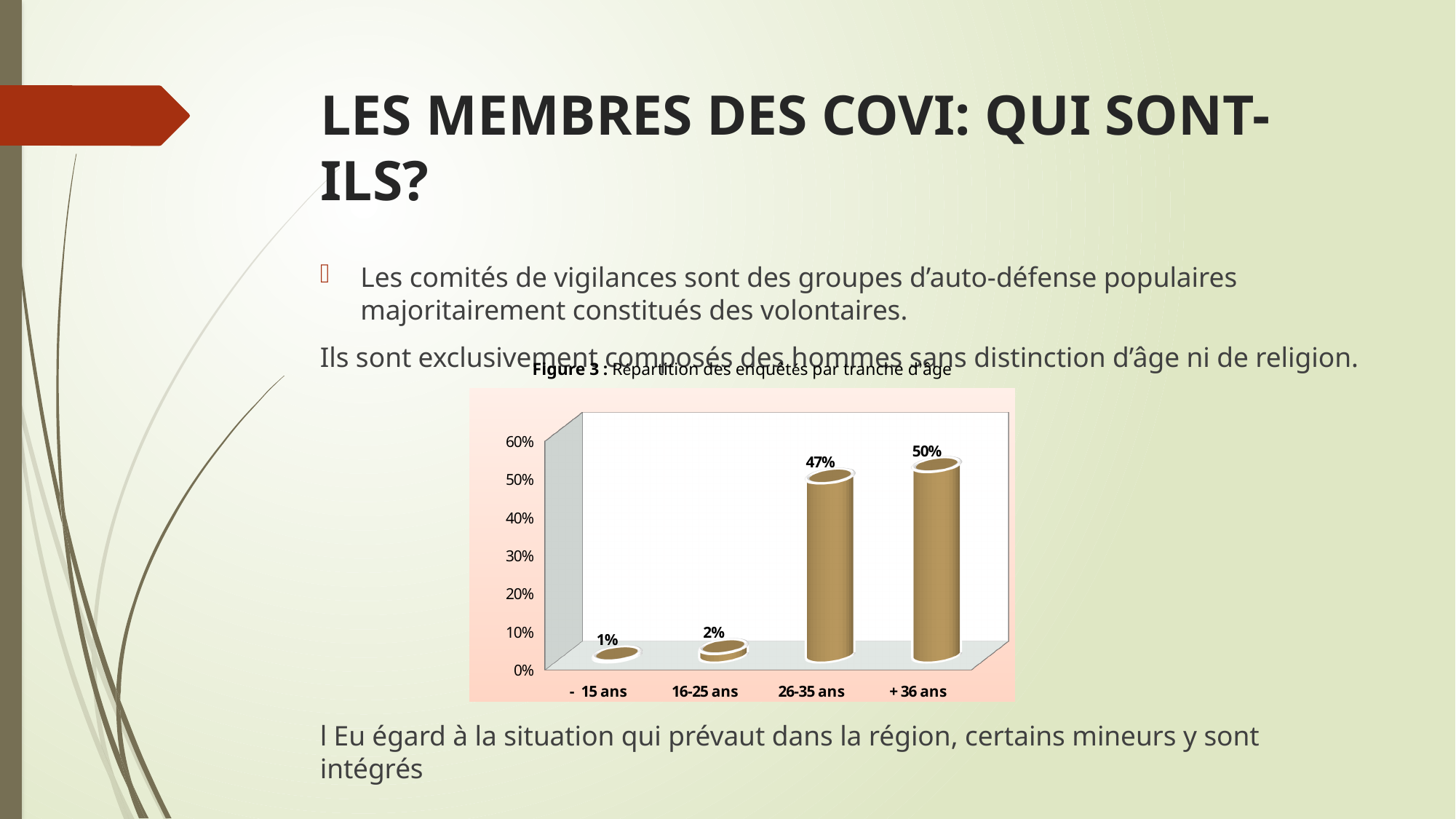
Which is larger, the value for 16-25 ans or the value for - 15 ans? 16-25 ans What is the difference between the values for + 36 ans and 26-35 ans? 3% What is the value for the - 15 ans age group? 1% Which age group has the lowest value? - 15 ans What is the title of the chart? Figure 3 : Répartition des enquêtés par tranche d'âge What is the value for the 16-25 ans age group? 2% Is the value for 26-35 ans greater or less than 40%? greater What kind of chart is shown on the slide? bar chart Which age group has the highest value? + 36 ans What is the value for the 26-35 ans age group? 47% What is the value for the + 36 ans age group? 50% How many age groups are shown on the chart? 4